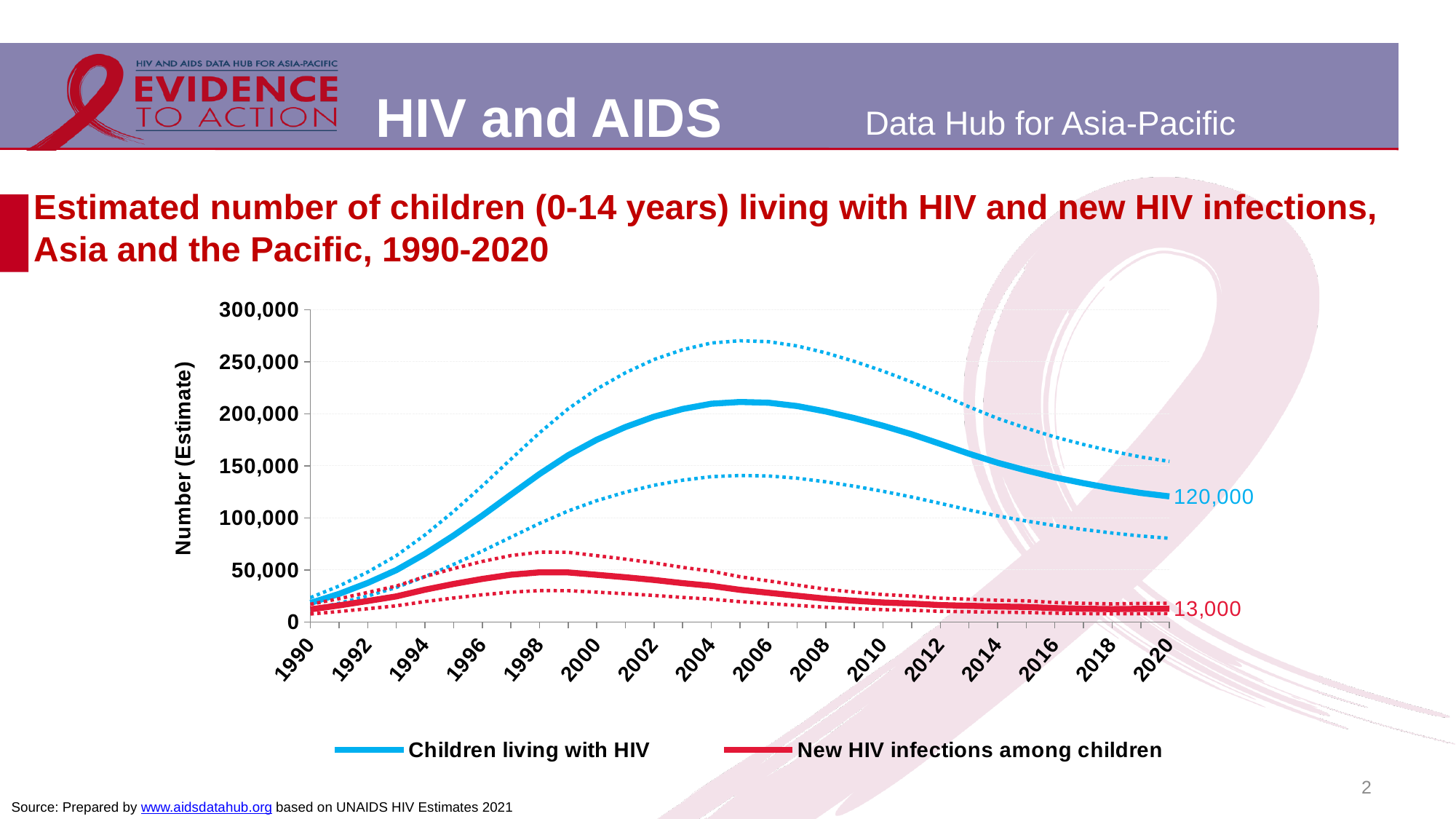
How many series does the legend list? 2 What is the value for New HIV infections among children in 2020? 13,000 What is the difference between Children living with HIV and New HIV infections among children in 2020? 107,000 Is the value for Children living with HIV in 1990 greater or less than 50,000? less Does the Children living with HIV line rise or fall between 1990 and 2004? Rises Does the Children living with HIV line rise or fall between 2006 and 2020? Falls Is the value for Children living with HIV in 2006 greater or less than 150,000? greater What colour is the line for Children living with HIV? Blue Is the value for New HIV infections among children in 1998 greater or less than 100,000? less What kind of chart is shown on the slide? Line chart In 2020, which series has the larger value: Children living with HIV or New HIV infections among children? Children living with HIV What is the value for Children living with HIV in 2020? 120,000